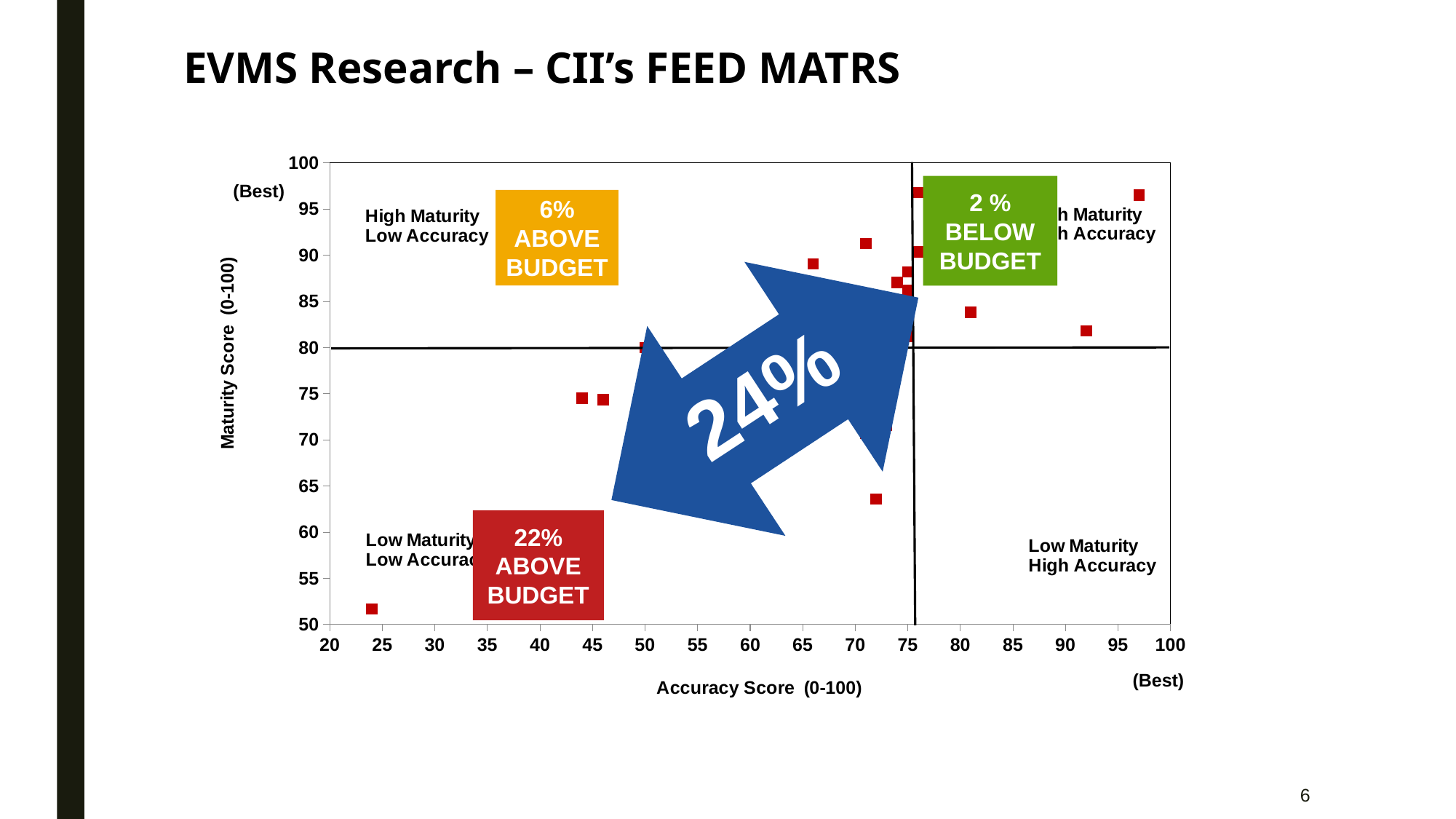
Is the green box in the upper-right quadrant labelled above or below budget? BELOW BUDGET What kind of chart is shown on the slide? scatter chart Is the maturity score of the point with the highest accuracy score greater or less than 95? greater Is the accuracy score of the rightmost data point greater or less than 95? greater What percentage is printed on the large blue arrow in the chart? 24% What percentage is shown in the green box in the High Maturity / High Accuracy quadrant? 2 % At what maturity score is the horizontal dividing line drawn? 80 What percentage is shown in the red box in the Low Maturity / Low Accuracy quadrant? 22% What is the label of the y axis? Maturity Score (0-100) What percentage is shown in the orange box in the High Maturity / Low Accuracy quadrant? 6% What is the label of the x axis? Accuracy Score (0-100) Is the maturity score of the leftmost data point greater or less than 55? less